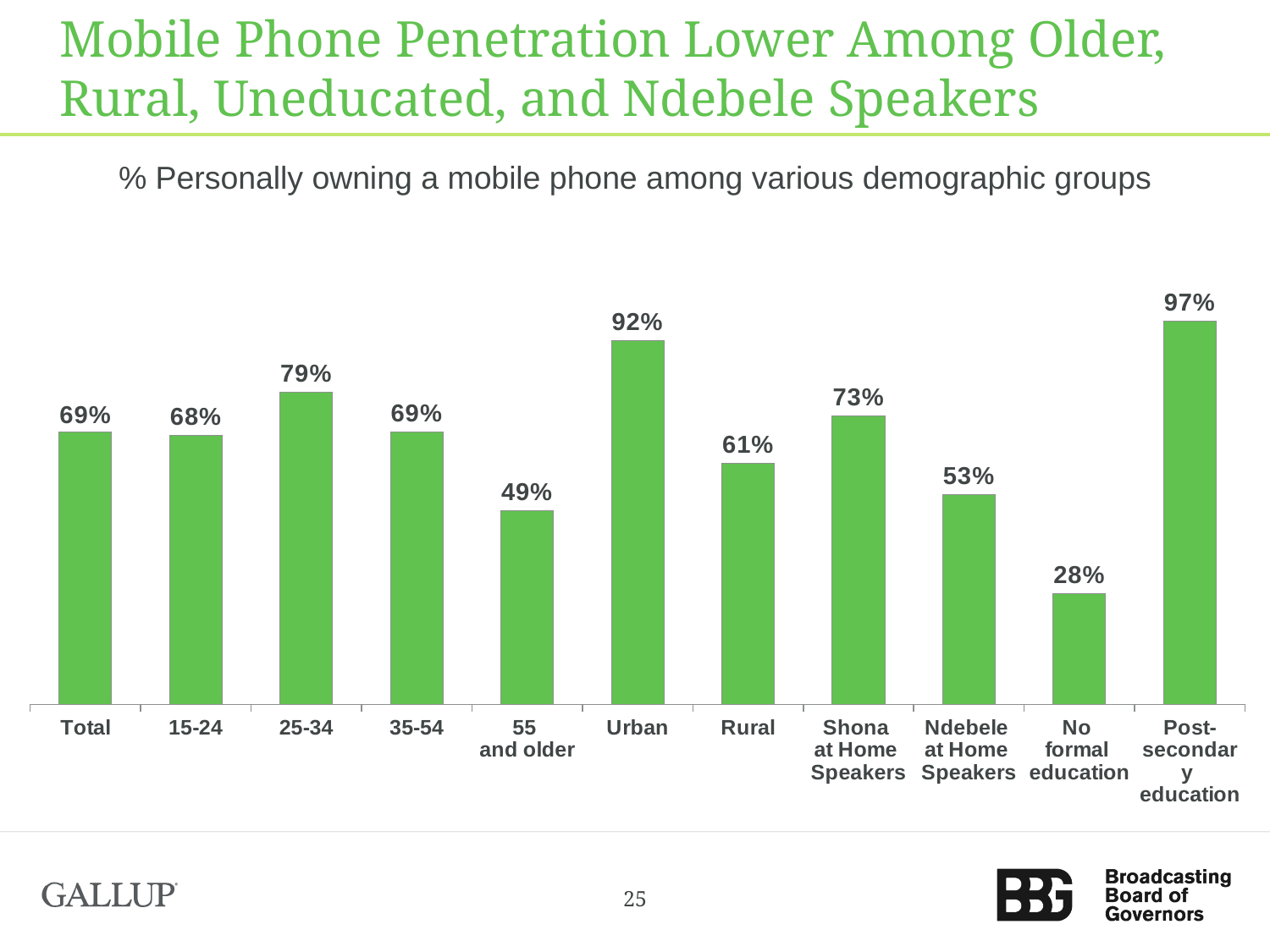
Which category has the highest mobile phone ownership? Post-secondary education What is the difference between Shona at Home Speakers and Ndebele at Home Speakers? 20% What is the value for the 55 and older group? 49% What is the value for Ndebele at Home Speakers? 53% Which is larger, the value for 25-34 or the value for 35-54? 25-34 Which category has the lowest mobile phone ownership? No formal education Do the values rise or fall across the age groups from 25-34 to 55 and older? Fall What is the difference between the Urban and Rural values? 31% What is the subtitle of the chart? % Personally owning a mobile phone among various demographic groups How many categories are shown on the chart? 11 What kind of chart is shown on the slide? Bar chart What percentage of Urban respondents personally own a mobile phone? 92%